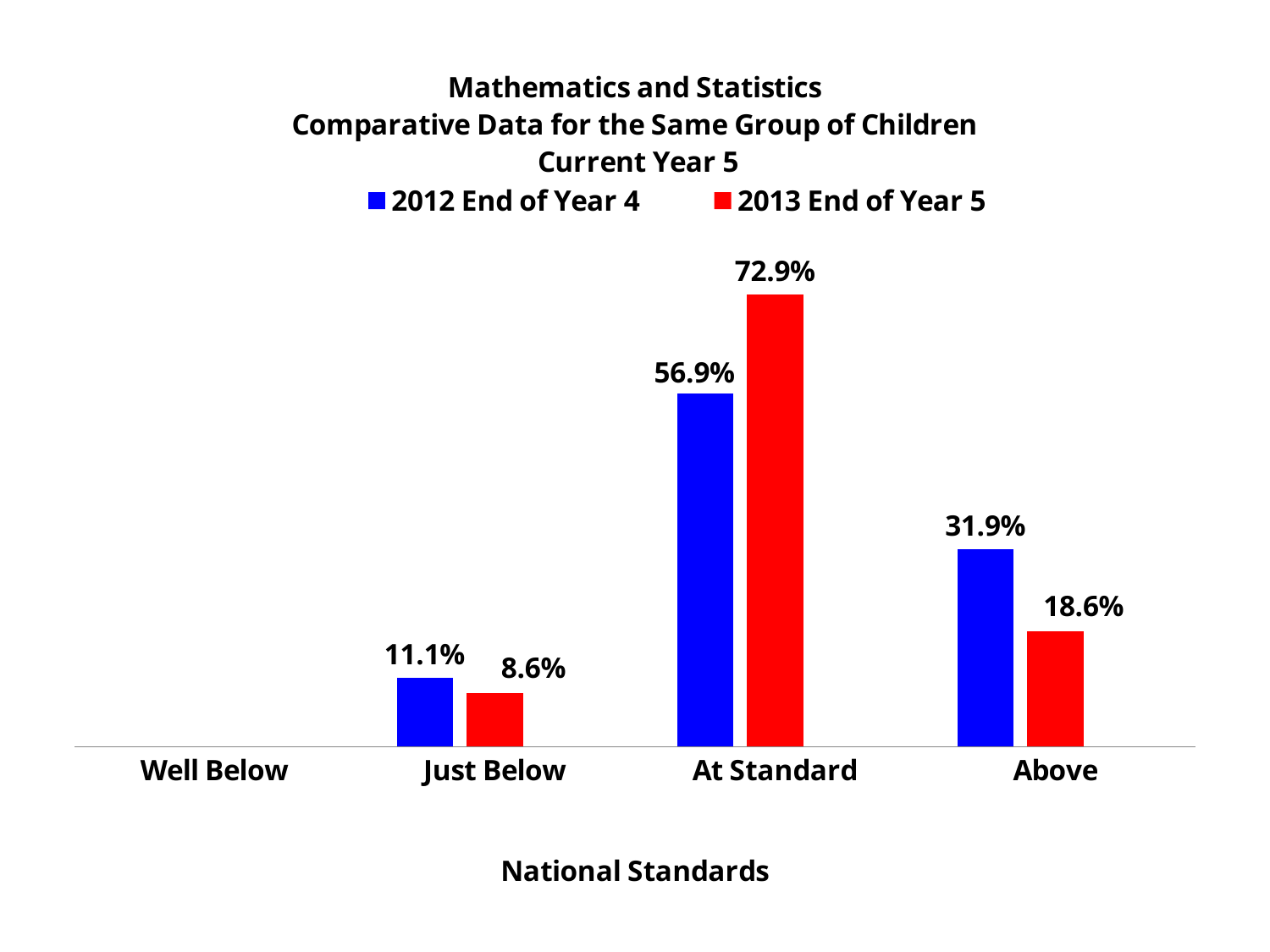
How many series does the legend list? 2 What is the difference between the 2013 End of Year 5 and 2012 End of Year 4 values for At Standard? 16.0% What is the value for At Standard in the 2013 End of Year 5 series? 72.9% Which is larger for Above: the 2012 End of Year 4 value or the 2013 End of Year 5 value? 2012 End of Year 4 What is the value for Above in the 2012 End of Year 4 series? 31.9% What is the difference between the 2012 End of Year 4 and 2013 End of Year 5 values for Above? 13.3% What kind of chart is shown on the slide? Bar chart What is the x-axis title of the chart? National Standards What is the value for Just Below in the 2013 End of Year 5 series? 8.6% How many categories are shown on the x axis? 4 Which category has the highest value in the 2012 End of Year 4 series? At Standard Which category with a printed value has the lowest value in the 2013 End of Year 5 series? Just Below